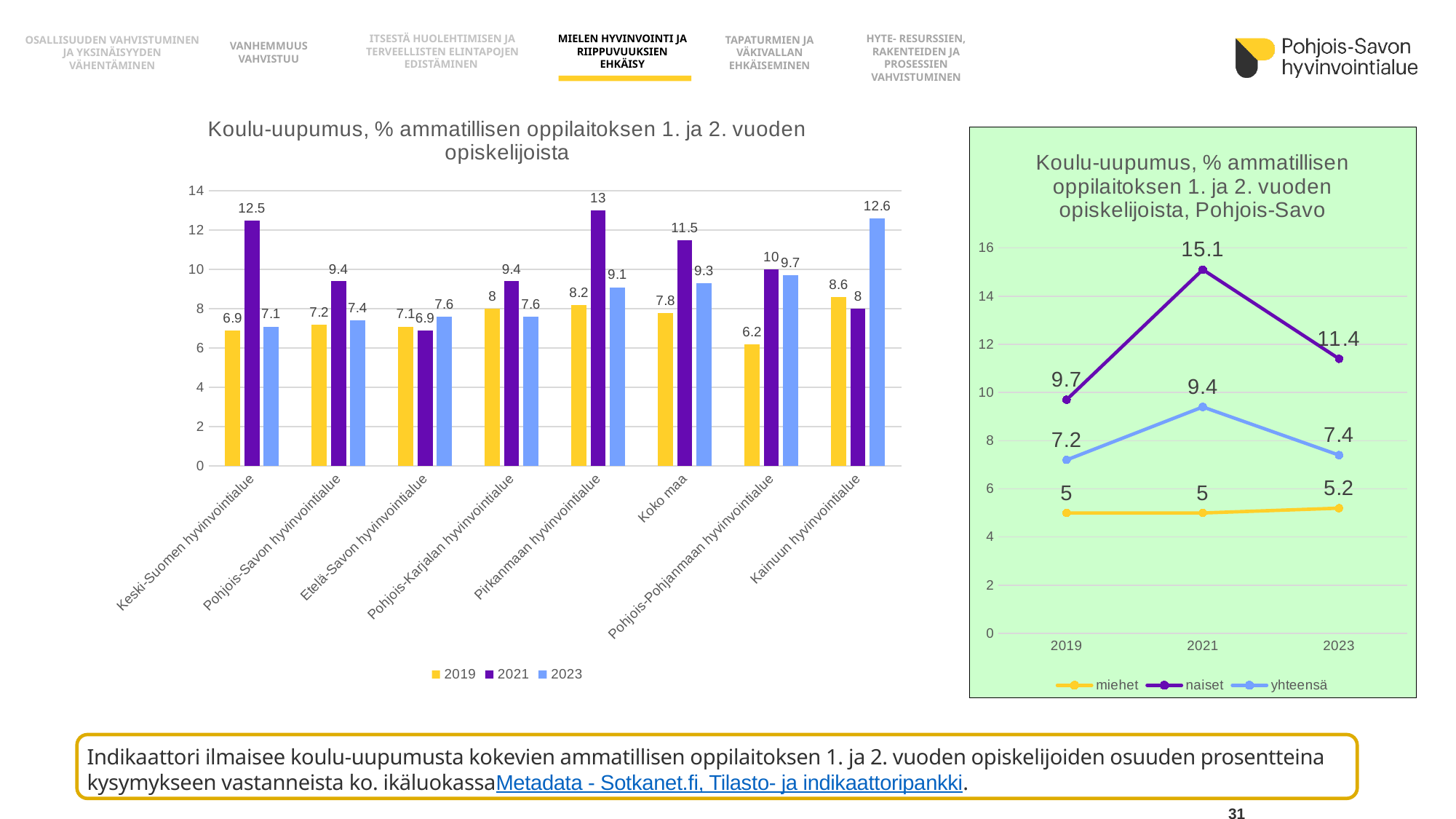
How many regions (categories) are shown in the left bar chart? 8 In the left bar chart, what is the 2021 value for Pirkanmaan hyvinvointialue? 13 In the left bar chart, which region has the lowest 2019 value? Pohjois-Pohjanmaan hyvinvointialue In the left bar chart, which is larger for Koko maa: the 2021 value or the 2023 value? 2021 In the right line chart, what is the difference between naiset and miehet in 2023? 6.2 In the left bar chart, what is the difference between the 2021 and 2019 values for Keski-Suomen hyvinvointialue? 5.6 In the right line chart, how does the yhteensä series change from 2021 to 2023? It falls What kind of chart is the chart on the right side of the slide? Line chart How many series does the legend of the left bar chart list? 3 Which series are listed in the legend of the right line chart? miehet, naiset, yhteensä In the right line chart, what is the value for naiset in 2021? 15.1 In the left bar chart, what is the 2023 value for Kainuun hyvinvointialue? 12.6